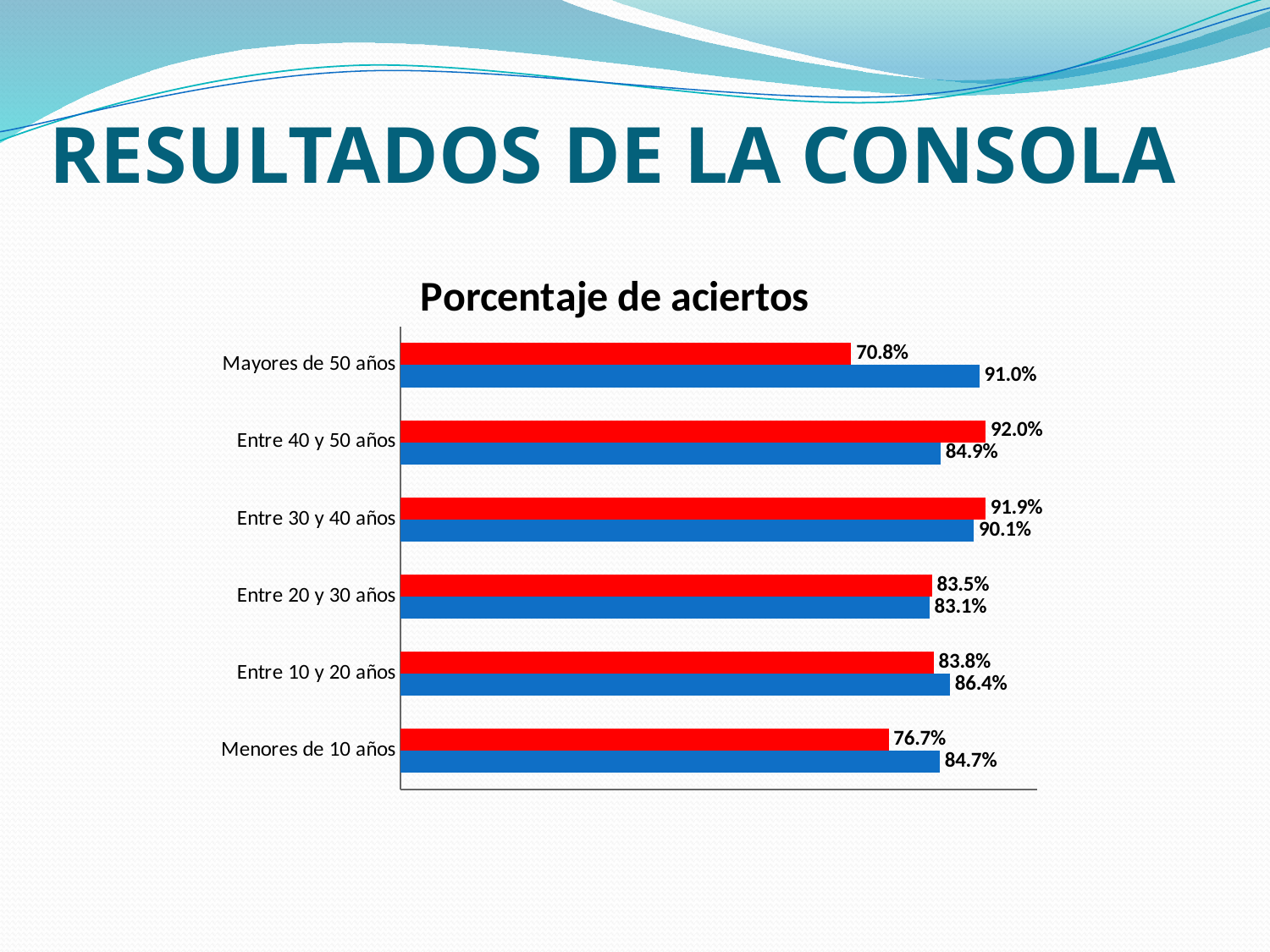
What kind of chart is shown on the slide? bar chart How many age categories are shown on the chart? 6 What is the value of the blue bar for Mayores de 50 años? 91.0% What is the value of the red bar for Entre 40 y 50 años? 92.0% What is the value of the blue bar for Entre 30 y 40 años? 90.1% What is the chart's title? Porcentaje de aciertos Which age category has the highest blue bar value? Mayores de 50 años What is the value of the blue bar for Menores de 10 años? 84.7% Which age category has the lowest red bar value? Mayores de 50 años Which age category has the lowest blue bar value? Entre 20 y 30 años What is the value of the red bar for Mayores de 50 años? 70.8% For Entre 10 y 20 años, which bar is larger, the red or the blue? blue